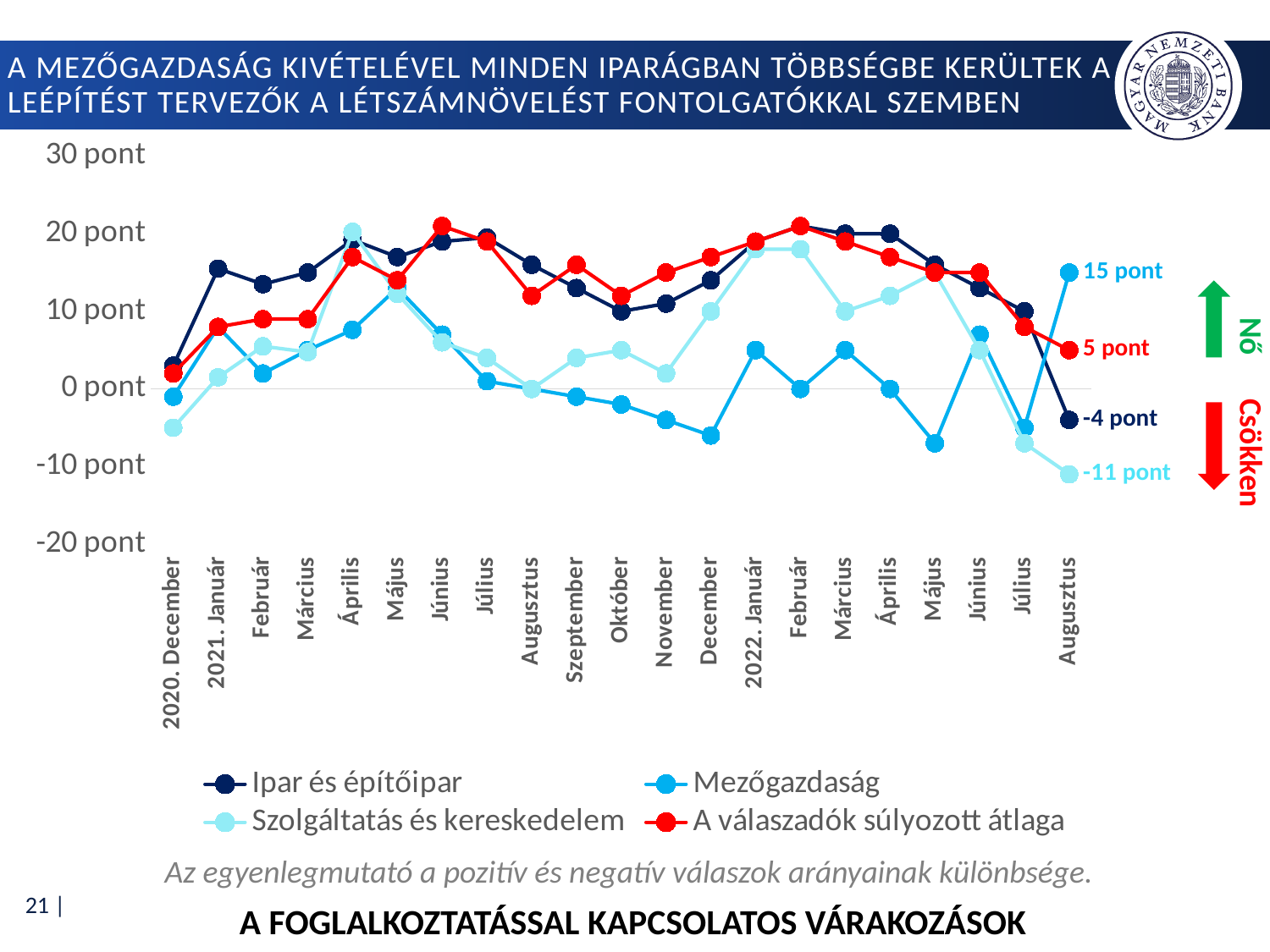
Which series has the highest value in Augusztus 2022? Mezőgazdaság What is the value for Szolgáltatás és kereskedelem in Augusztus 2022, as labelled at the end of the line? -11 pont Is the value for Ipar és építőipar in 2021. Január greater or less than 10 pont? greater What is the value for Mezőgazdaság in Augusztus 2022, as labelled at the end of the line? 15 pont How many months are shown on the x axis? 21 In Augusztus 2022, how much higher is Mezőgazdaság than Szolgáltatás és kereskedelem? 26 pont Which series has the lowest value in Augusztus 2022? Szolgáltatás és kereskedelem In Augusztus 2022, which is larger: Mezőgazdaság or Ipar és építőipar? Mezőgazdaság What is the value for Ipar és építőipar in Augusztus 2022, as labelled at the end of the line? -4 pont What kind of chart is shown on the slide? Line chart How many series does the legend list? 4 What is the value for A válaszadók súlyozott átlaga in Augusztus 2022, as labelled at the end of the line? 5 pont